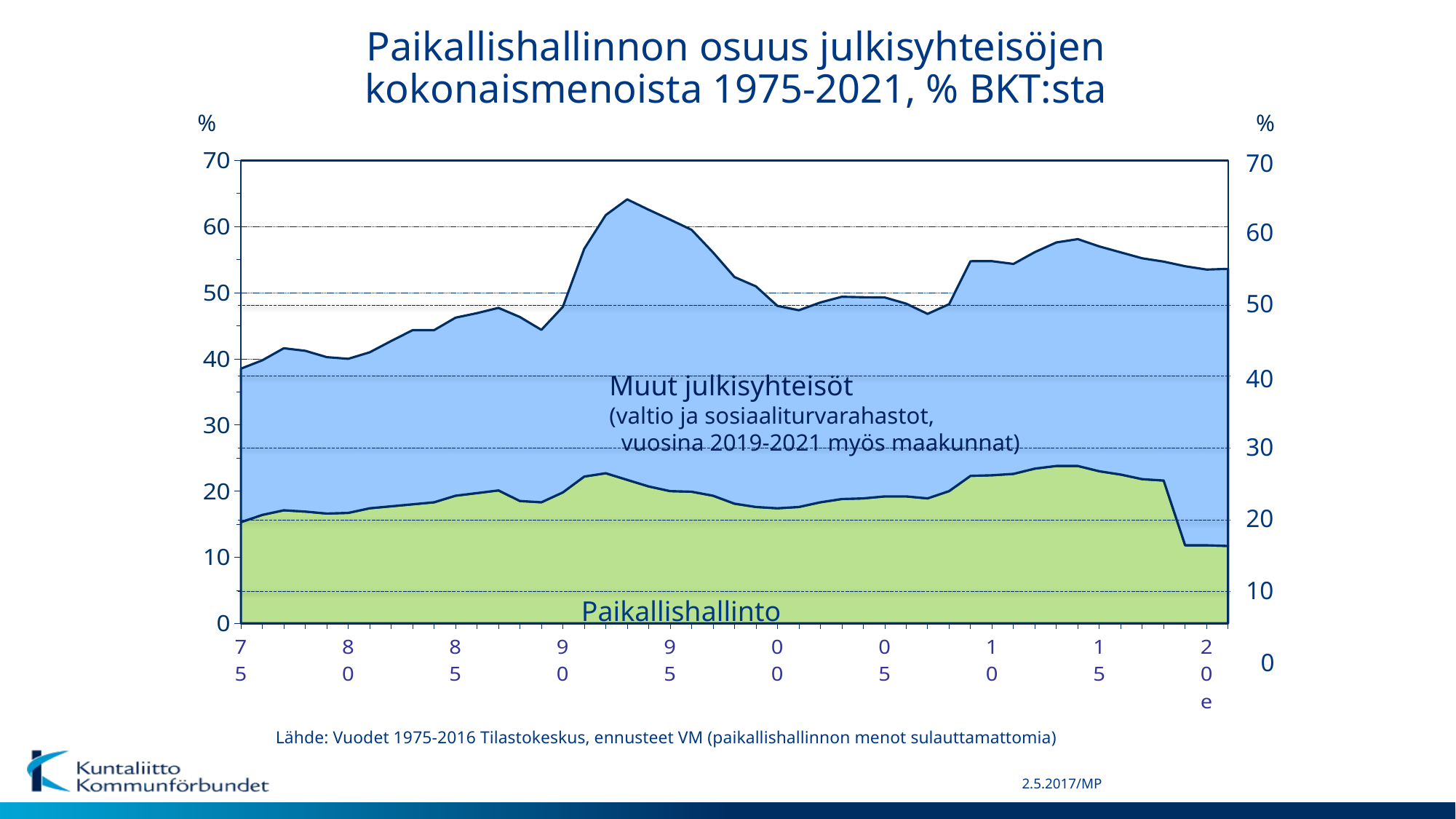
Is the value for Paikallishallinto in 2020 greater or less than 20? less Is the value for Paikallishallinto in 2015 greater or less than 20? greater What is the title of the chart? Paikallishallinnon osuus julkisyhteisöjen kokonaismenoista 1975-2021, % BKT:sta Does the value for Paikallishallinto rise or fall between 2015 and 2020? fall What kind of chart is shown on the slide? Stacked area chart How many series are plotted in the chart? 2 Which series is shown in green at the bottom of the chart? Paikallishallinto Is the value for Paikallishallinto in 1975 greater or less than 20? less Which is larger, the total of the stacked areas in 1975 or in 2015? 2015 Which is larger, the value for Paikallishallinto in 2015 or in 2020? 2015